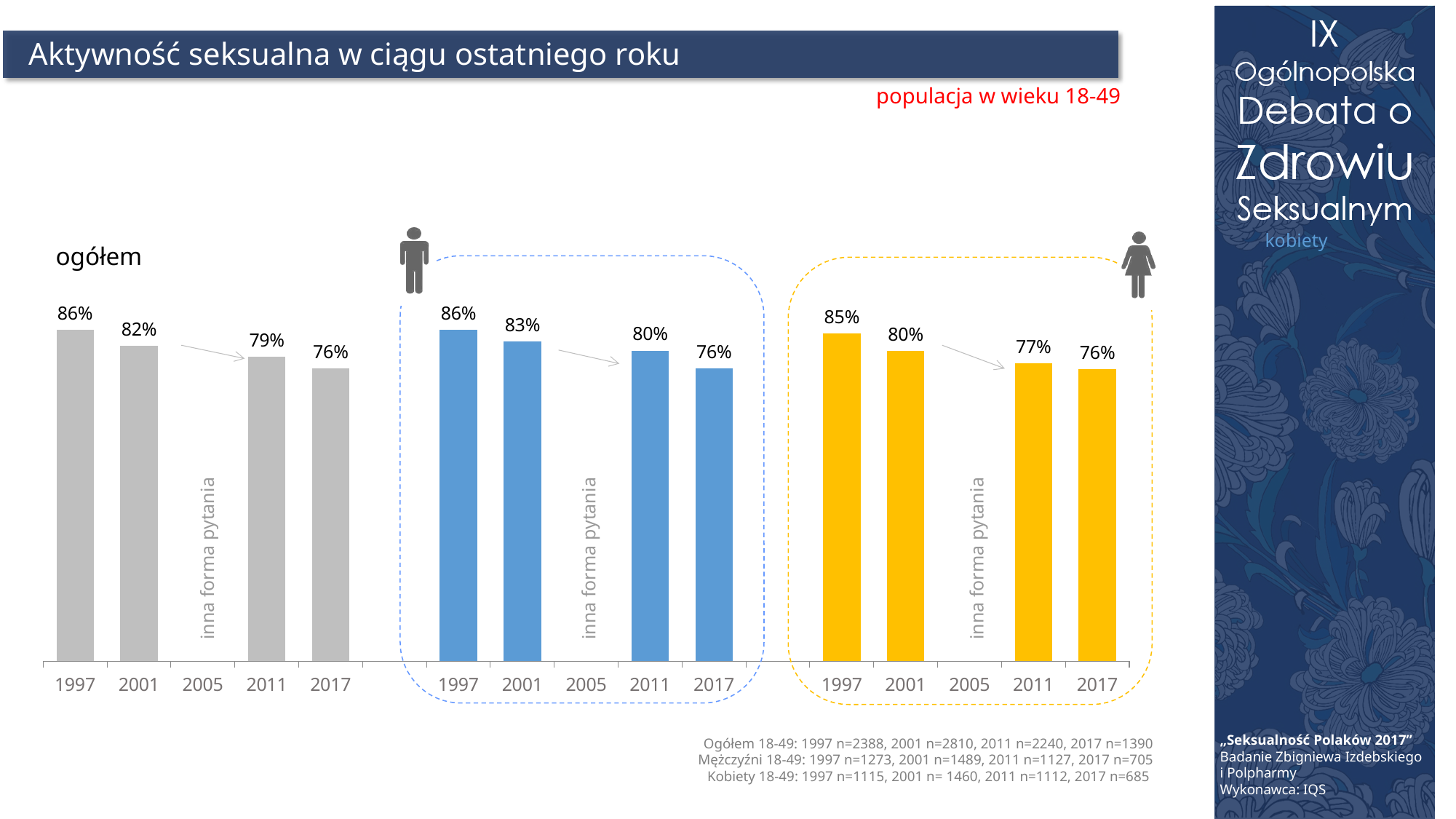
In the middle chart (blue bars, men), which year has the highest value? 1997 In the left chart titled "ogółem", what is the value for 1997? 86% In the right chart (yellow bars, women), what is the difference between the 2001 value and the 2011 value? 3 percentage points In the left chart titled "ogółem", which year has the lowest value? 2017 In the middle chart (blue bars, men), what is the value for 2001? 83% Which is larger: the 2011 value in the middle chart (men) or the 2011 value in the right chart (women)? Men (80%) In the left chart titled "ogółem", what is the value for 2011? 79% In the middle chart (blue bars, men), do the values rise or fall from 1997 to 2017? Fall What type of chart is used on this slide? Bar chart In the right chart (yellow bars, women), what is the value for 1997? 85% In the right chart (yellow bars, women), what is the value for 2011? 77% In the left chart titled "ogółem", what is the difference between the 1997 value and the 2017 value? 10 percentage points